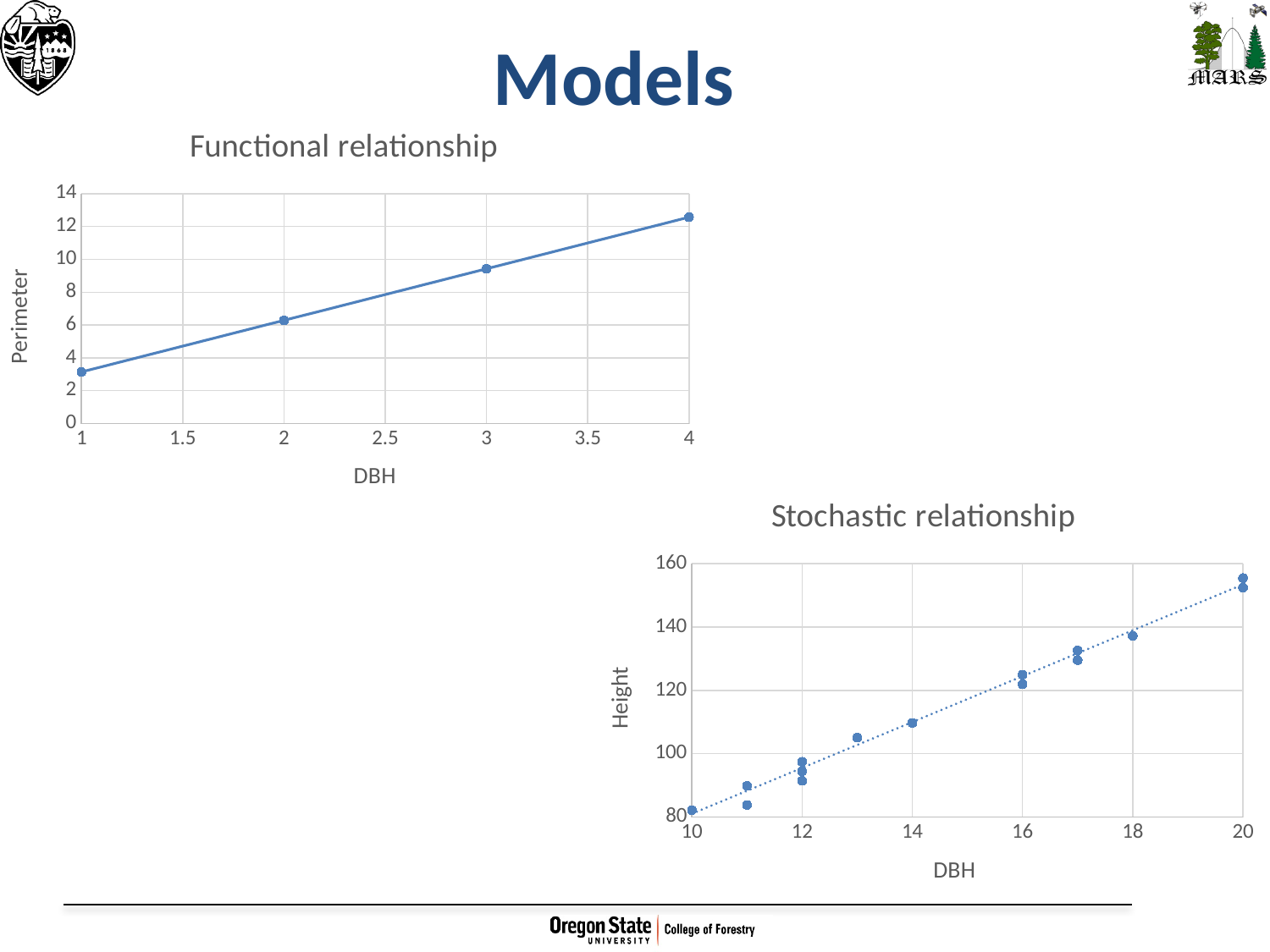
What type of chart is the 'Stochastic relationship' chart? scatter chart In the 'Stochastic relationship' chart, does Height generally rise or fall as DBH increases? rise In the 'Stochastic relationship' chart, is the Height at DBH 14 greater or less than 100? greater In the 'Functional relationship' chart, is the Perimeter at DBH 3 greater or less than 8? greater What type of chart is the 'Functional relationship' chart? line chart In the 'Stochastic relationship' chart, is the Height at DBH 18 greater or less than 140? less In the 'Stochastic relationship' chart, at which DBH value are the highest Height points plotted? 20 In the 'Functional relationship' chart, does Perimeter rise or fall as DBH increases? rise In the 'Functional relationship' chart, how many data points are plotted? 4 What is the y-axis label of the 'Stochastic relationship' chart? Height